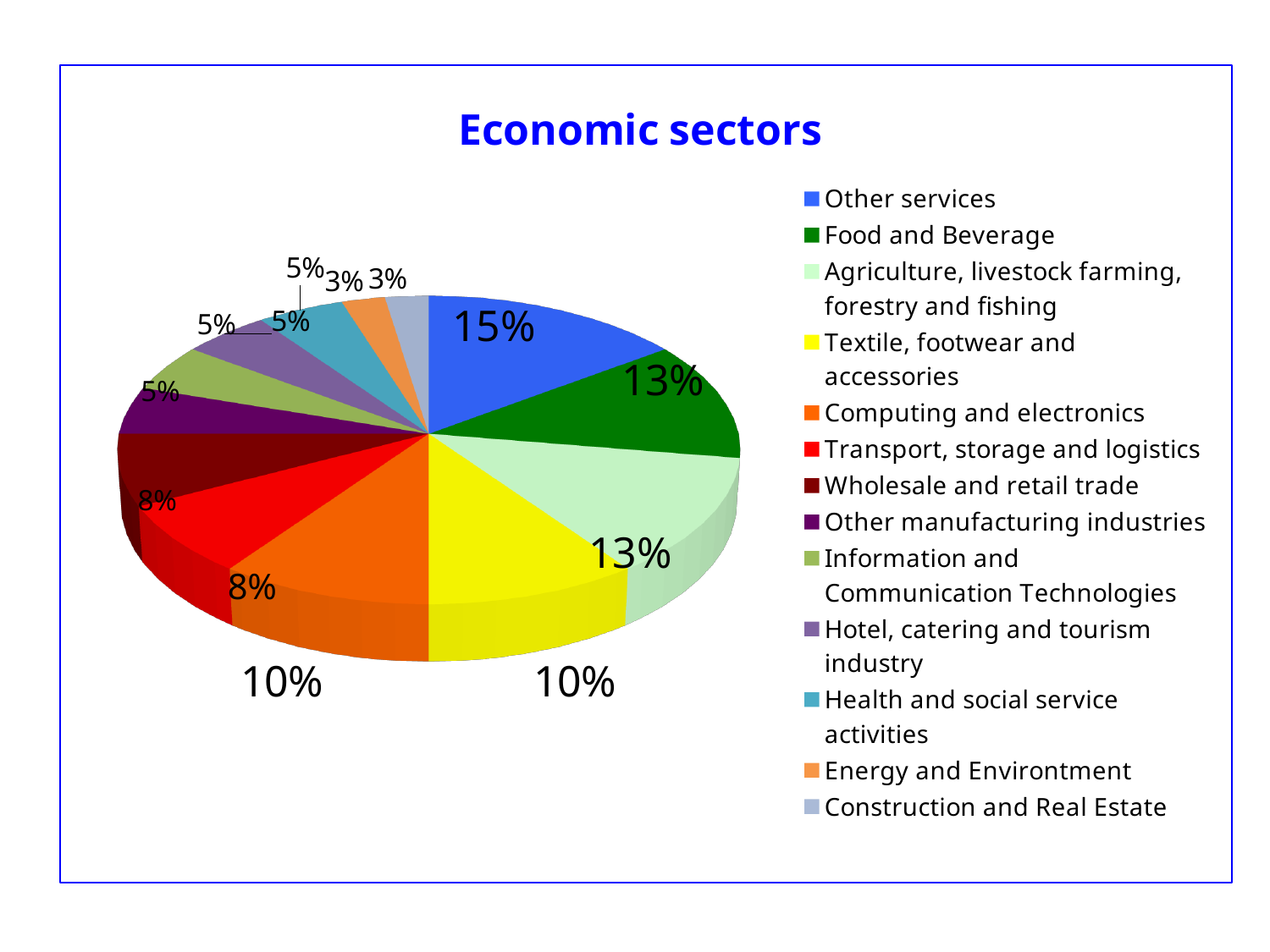
What share of the pie does Other services account for? 15% How many sectors are listed in the legend? 13 Which is larger, the share for Computing and electronics or the share for Wholesale and retail trade? Computing and electronics Which sector has the largest slice of the pie? Other services What percentage is shown for Textile, footwear and accessories? 10% What percentage is shown for Transport, storage and logistics? 8% What kind of chart is shown on the slide? Pie chart What percentage is shown for Energy and Environtment? 3% Which is larger, the share for Other services or the share for Food and Beverage? Other services What percentage is shown for Food and Beverage? 13% What is the title of the chart? Economic sectors What is the difference in percentage points between Other services and Food and Beverage? 2 percentage points